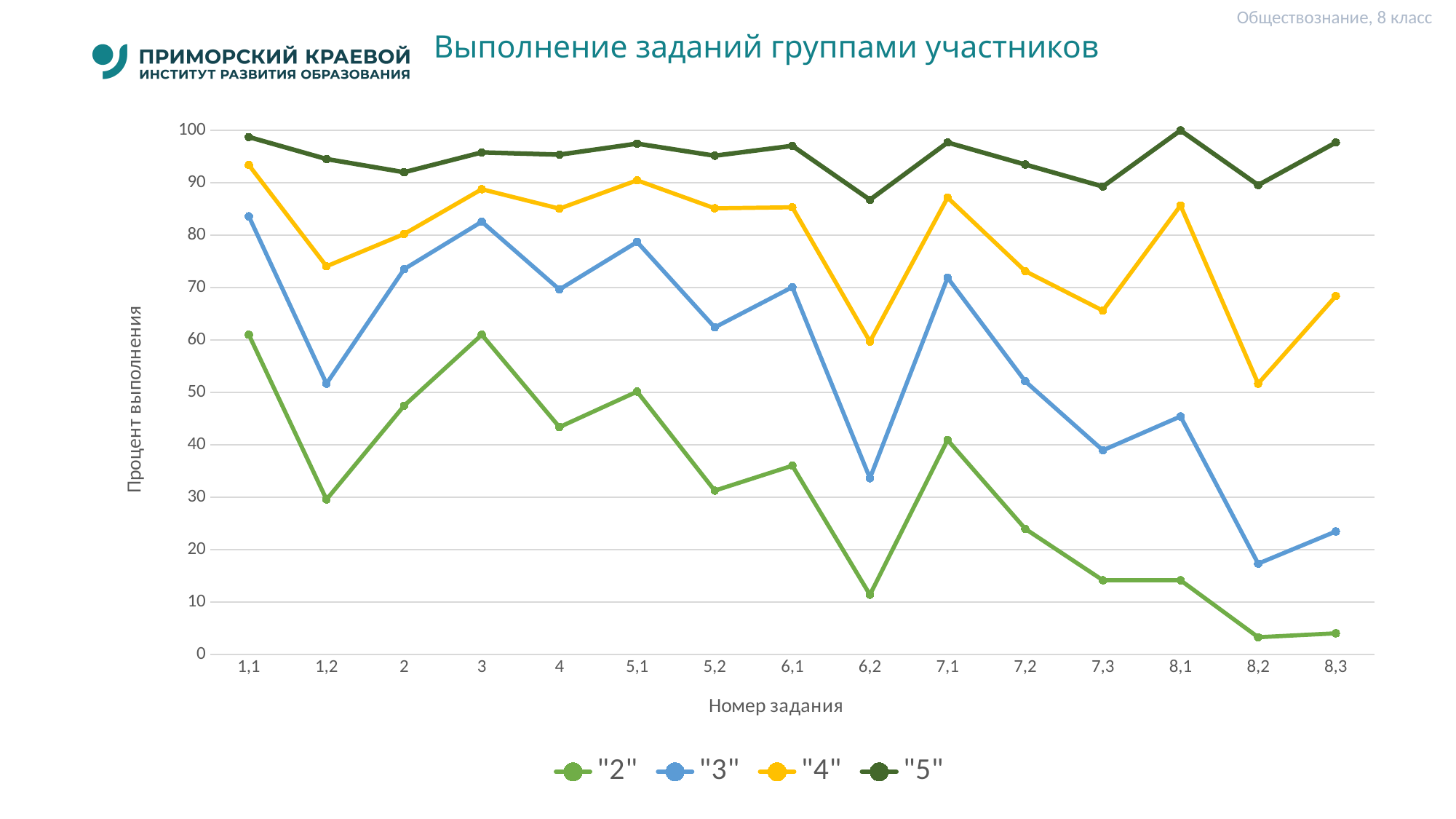
Is the value for series "4" at task 6,2 greater or less than 70? less How many task numbers are shown along the x axis? 15 Is the value for series "5" at task 8,1 greater or less than 90? greater How many series does the legend list? 4 Is the value for series "3" at task 8,2 greater or less than 20? less Does series "2" generally rise or fall from task 7,1 to task 8,2? fall For series "2", which is higher: the value at task 3 or the value at task 4? task 3 What kind of chart is shown on the slide? line chart For series "3", which task has the lowest value? 8,2 What is the title of the y axis? Процент выполнения For series "4", which task has the lowest value? 8,2